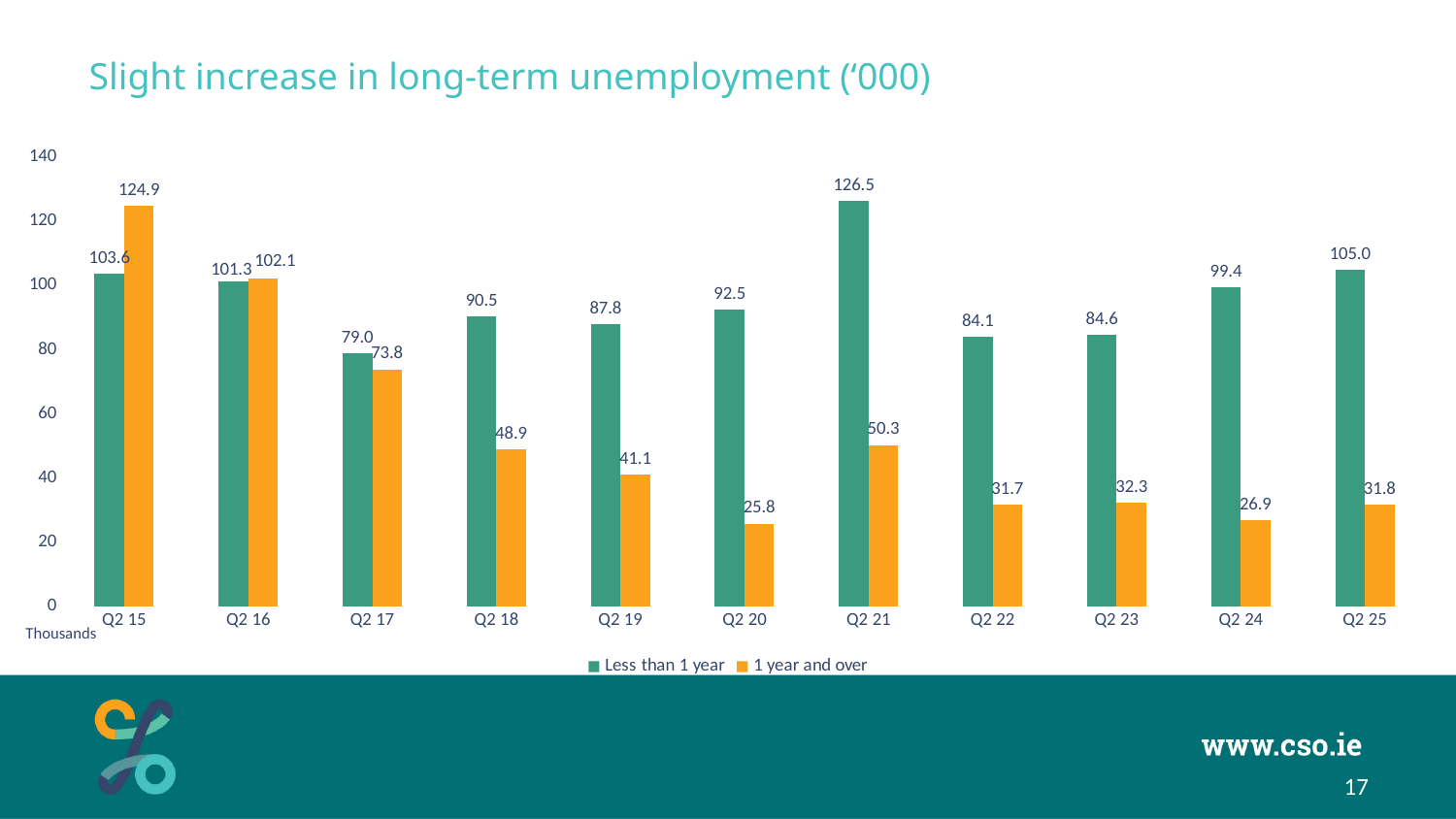
In which quarter is the '1 year and over' value lowest? Q2 20 Which is larger in Q2 15: 'Less than 1 year' or '1 year and over'? 1 year and over In which quarter is the 'Less than 1 year' value highest? Q2 21 What is the value for 'Less than 1 year' in Q2 21? 126.5 What is the title of the chart? Slight increase in long-term unemployment ('000) What is the value for '1 year and over' in Q2 20? 25.8 What kind of chart is shown on the slide? Bar chart Is the '1 year and over' value for Q2 18 greater or less than 40? greater What is the value for '1 year and over' in Q2 25? 31.8 What is the difference between the 'Less than 1 year' and '1 year and over' values in Q2 25? 73.2 How many quarters are shown on the x axis? 11 How many series does the legend list? 2